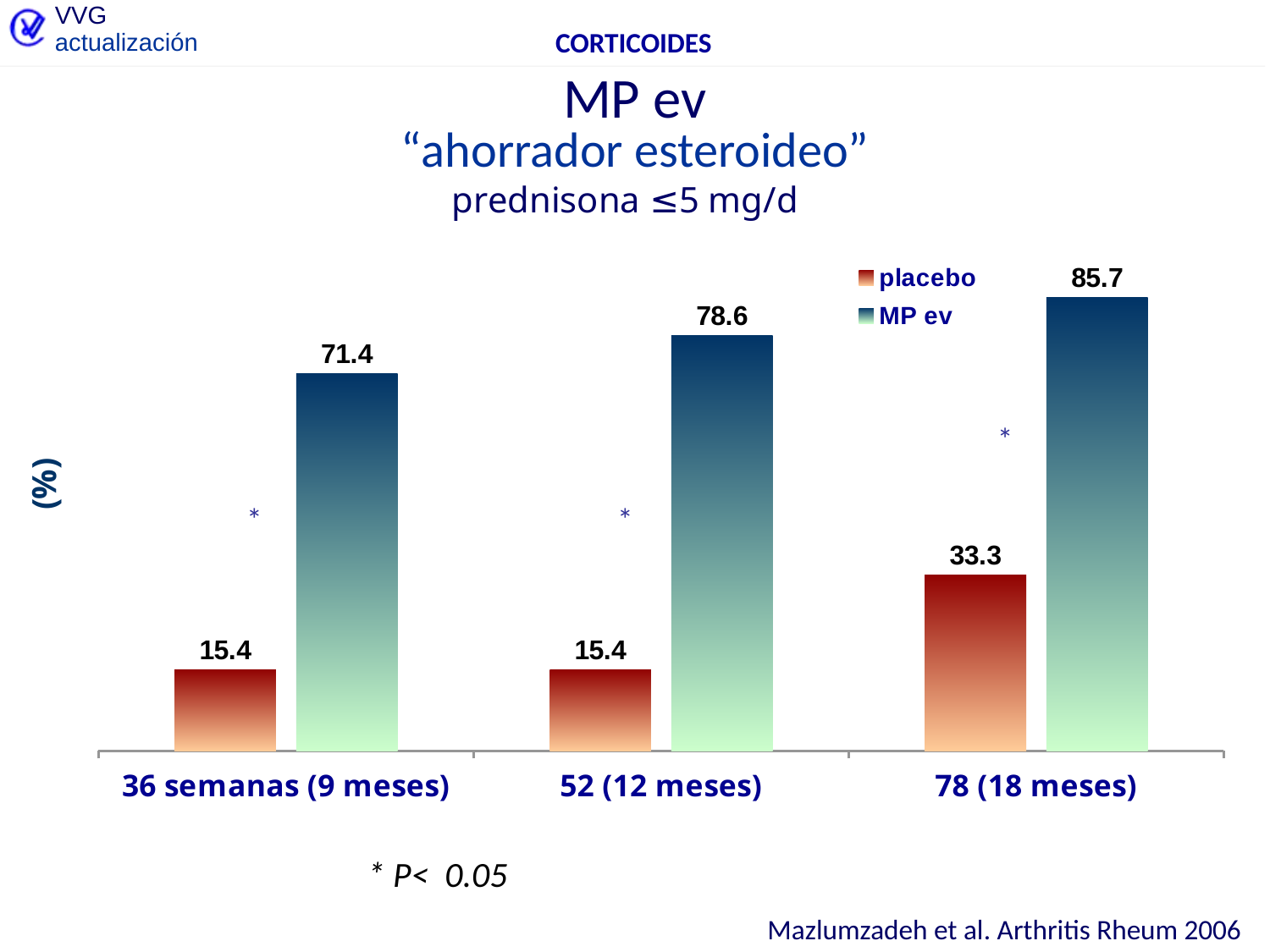
What is the value for placebo at 78 (18 meses)? 33.3 What is the difference between MP ev and placebo at 78 (18 meses)? 52.4 Do the MP ev values rise or fall from 36 semanas to 78 semanas? rise Which is larger at 36 semanas (9 meses), placebo or MP ev? MP ev How many series does the legend list? 2 What is the difference between MP ev and placebo at 52 (12 meses)? 63.2 What is the value for MP ev at 36 semanas (9 meses)? 71.4 What is the value for placebo at 52 (12 meses)? 15.4 At which time point is the placebo value highest? 78 (18 meses) How many time-point categories are shown on the x axis? 3 What kind of chart is shown on the slide? bar chart At which time point is the MP ev value highest? 78 (18 meses)